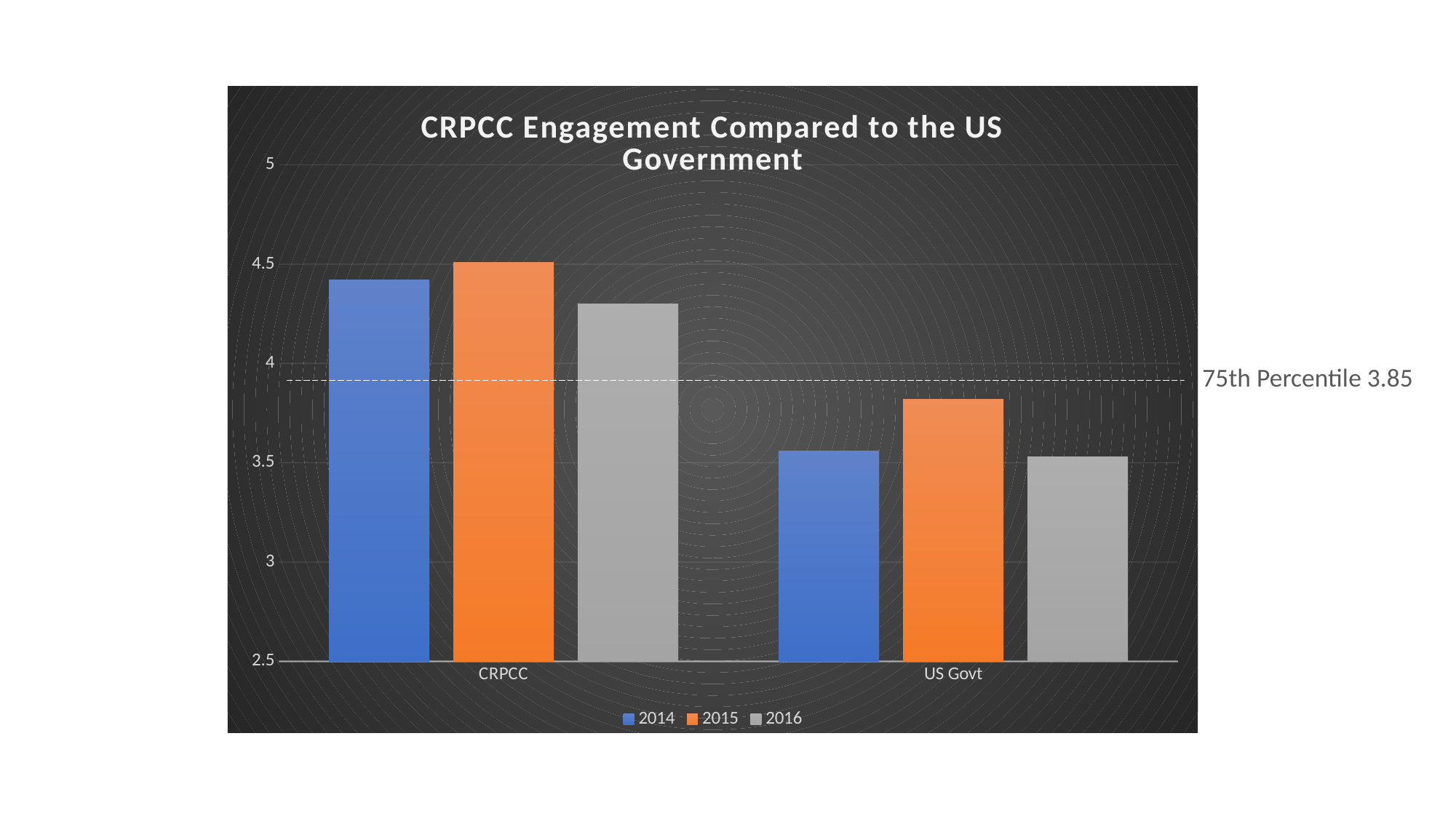
Which year has the highest value for CRPCC? 2015 How many categories are shown on the x axis? 2 Which is larger, the 2014 value for CRPCC or the 2014 value for US Govt? CRPCC Is the value for US Govt in 2016 greater or less than 4? less What is the title of the chart? CRPCC Engagement Compared to the US Government Which year has the lowest value for CRPCC? 2016 What value does the dashed horizontal line represent, according to its label? 75th Percentile 3.85 What kind of chart is shown on the slide? bar chart Is the value for CRPCC in 2014 greater or less than 4? greater Is the value for US Govt in 2015 greater or less than 4? less How many series does the legend list? 3